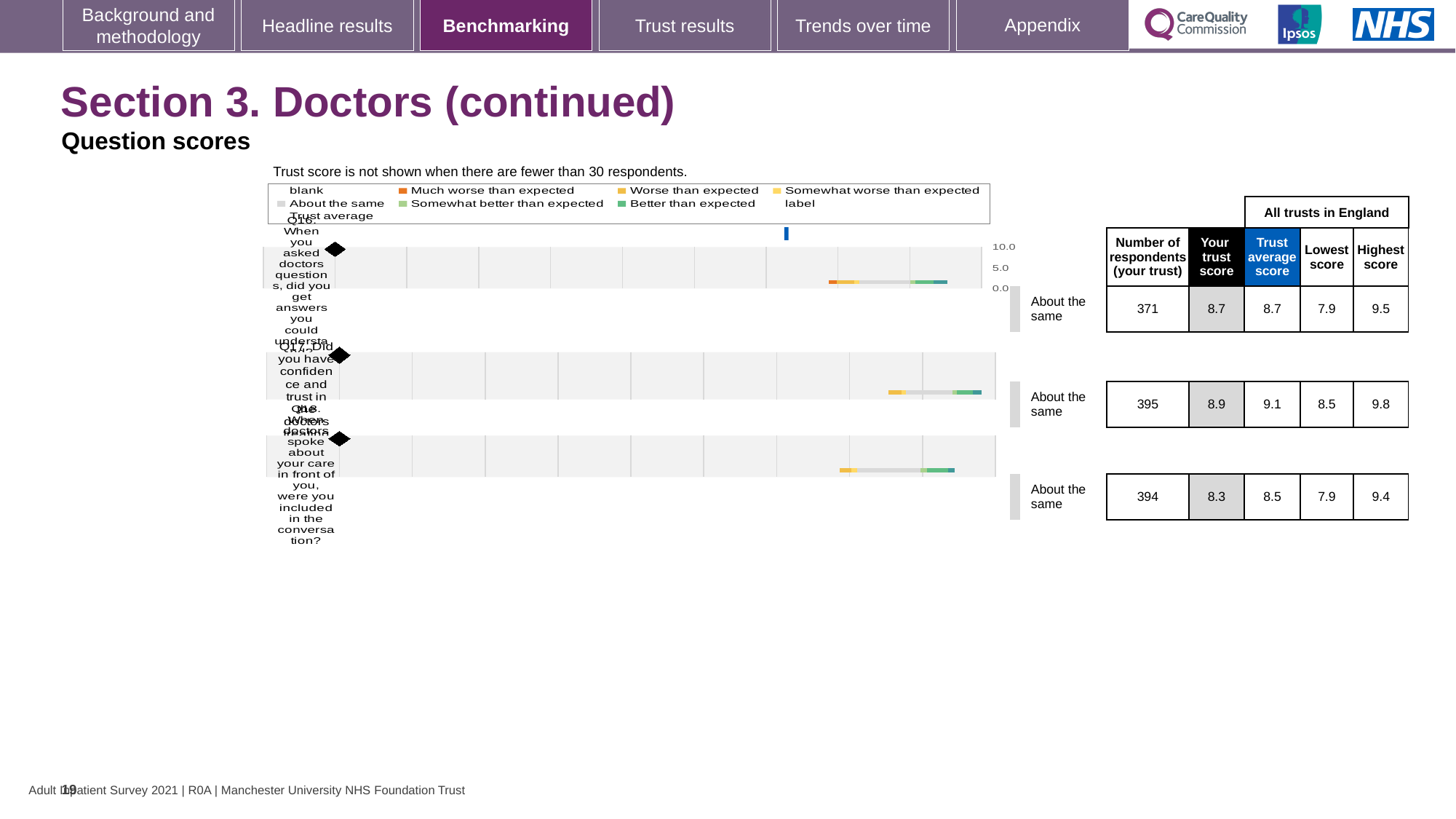
Which question has the highest 'Your trust score'? Q17 How many respondents does the trust have for Q18 (included in the conversation)? 394 Which question has the lowest 'Your trust score'? Q18 What is the maximum value shown on the chart's score axis? 10.0 What is the difference between the highest score and the lowest score for Q17? 1.3 What kind of chart is used to show the question scores on this slide? bar chart Is the trust score for Q17 greater or less than 5.0 on the chart axis? greater What is the 'Your trust score' value for Q17 (confidence and trust in the doctors)? 8.9 For Q18, which is larger: the trust's own score or the trust average score? Trust average score What benchmark category is shown for Q16? About the same What is the trust average score for Q16 (getting answers you could understand)? 8.7 How many questions are plotted in the question scores chart? 3